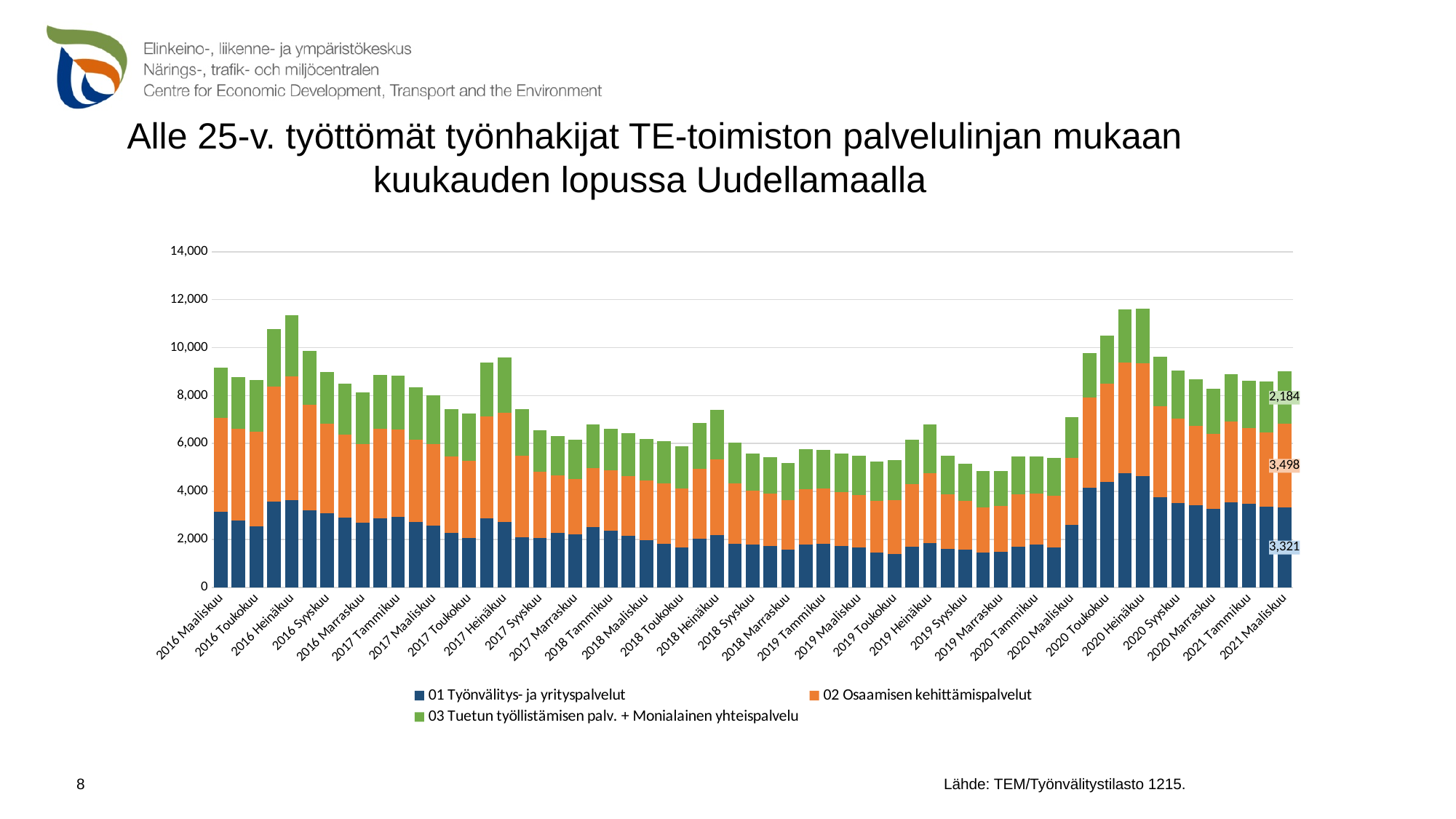
How many series does the legend list? 3 Is the total value for 2020 Heinäkuu greater or less than 10,000? greater What is the value for 03 Tuetun työllistämisen palv. + Monialainen yhteispalvelu in 2021 Maaliskuu? 2,184 What kind of chart is shown on the slide? Stacked bar chart In 2021 Maaliskuu, what is the difference between 02 Osaamisen kehittämispalvelut and 01 Työnvälitys- ja yrityspalvelut? 177 Is the total value for 2019 Marraskuu greater or less than 6,000? less In 2021 Maaliskuu, which is larger: 01 Työnvälitys- ja yrityspalvelut or 03 Tuetun työllistämisen palv. + Monialainen yhteispalvelu? 01 Työnvälitys- ja yrityspalvelut Do the total bar heights rise or fall from 2020 Maaliskuu to 2020 Heinäkuu? rise What is the value for 01 Työnvälitys- ja yrityspalvelut in 2021 Maaliskuu? 3,321 What is the value for 02 Osaamisen kehittämispalvelut in 2021 Maaliskuu? 3,498 What is the total of the stacked bar for 2021 Maaliskuu? 9,003 Which series is shown in green in the chart? 03 Tuetun työllistämisen palv. + Monialainen yhteispalvelu